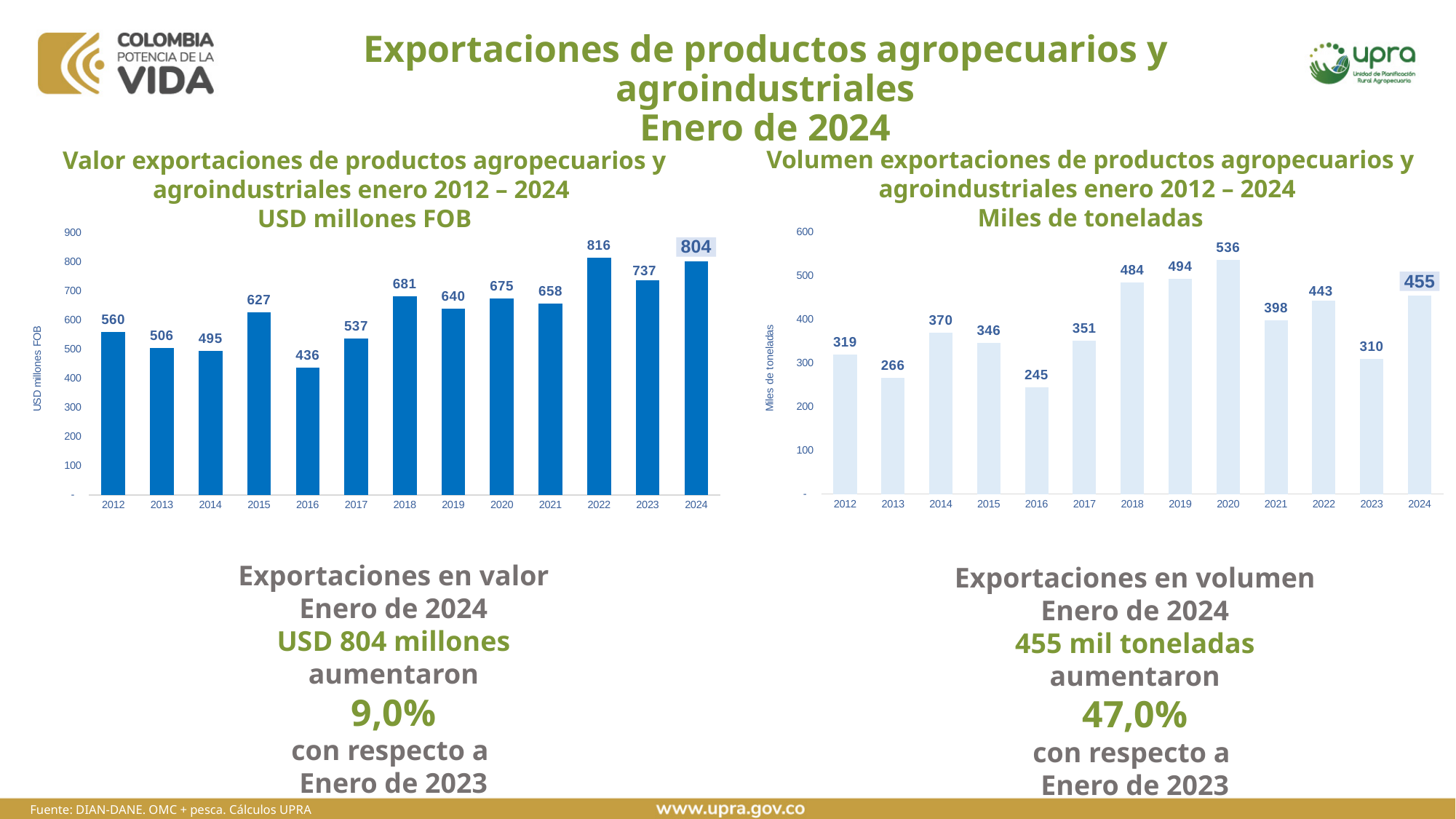
In the right chart (Volumen exportaciones, Miles de toneladas), what is the value for 2020? 536 In the left chart (Valor exportaciones, USD millones FOB), which year has the lowest value? 2016 In the right chart (Volumen exportaciones, Miles de toneladas), which year has the lowest value? 2016 In the left chart (Valor exportaciones, USD millones FOB), which year has the highest value? 2022 In the right chart (Volumen exportaciones, Miles de toneladas), which is larger, the value for 2018 or the value for 2021? 2018 In the left chart (Valor exportaciones, USD millones FOB), how many years are plotted? 13 In the right chart (Volumen exportaciones, Miles de toneladas), what is the difference between the 2024 value and the 2023 value? 145 What is the y-axis label of the right chart (Volumen exportaciones)? Miles de toneladas In the left chart (Valor exportaciones, USD millones FOB), what is the value for 2024? 804 What type of chart is the right chart (Volumen exportaciones, Miles de toneladas)? Bar chart In the left chart (Valor exportaciones, USD millones FOB), what is the difference between the 2024 value and the 2023 value? 67 In the left chart (Valor exportaciones, USD millones FOB), is the value for 2019 greater or less than 600? greater